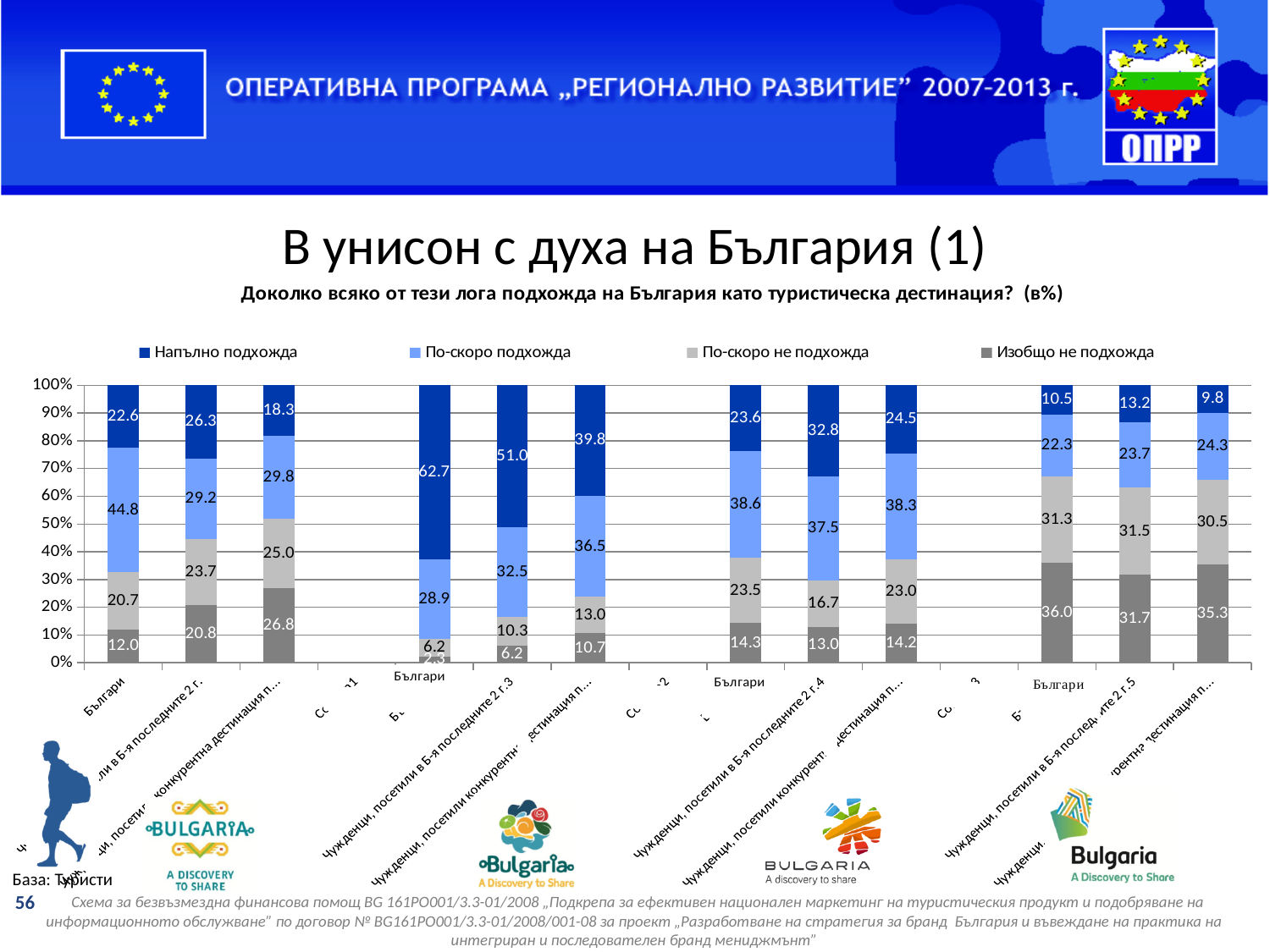
Which is larger: the "По-скоро подхожда" value of the leftmost bar or that of the second bar from the left? The leftmost bar (44.8) Which bar has the lowest "Напълно подхожда" value? The rightmost bar (fourth logo), 9.8 Which bar has the highest "Напълно подхожда" value? The fourth bar from the left (Българи, second logo), 62.7 How many series does the chart legend list? 4 What is the "Напълно подхожда" value for the leftmost bar (Българи, first logo)? 22.6 How many bars are plotted in the chart? 12 What kind of chart is shown on the slide? Stacked bar chart Which legend entry is shown in dark blue? Напълно подхожда What is the "По-скоро подхожда" value for the fourth bar from the left (Българи, second logo)? 28.9 What is the "Изобщо не подхожда" value for the leftmost bar (Българи, first logo)? 12.0 What is the difference between the "Напълно подхожда" values of the fourth bar (62.7) and the fifth bar (51.0)? 11.7 What is the "Изобщо не подхожда" value for the tenth bar from the left (Българи, fourth logo)? 36.0